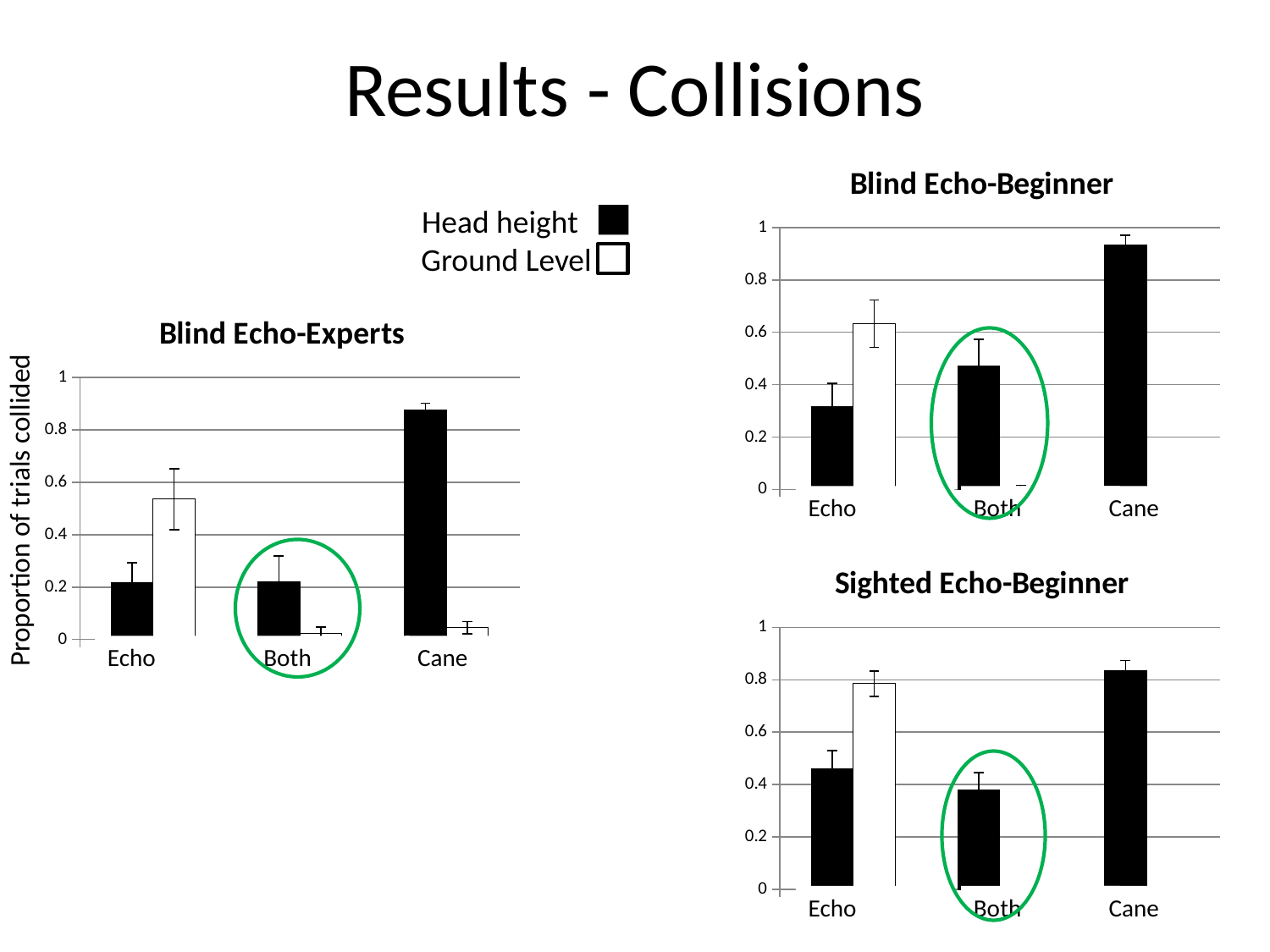
According to the legend, what colour represents Head height? black In the Sighted Echo-Beginner chart, which category has the lowest Head height bar? Both In the Blind Echo-Beginner chart, is the Head height value for Both greater or less than 0.6? less What kind of chart is the Blind Echo-Experts chart? bar chart How many categories are shown on the x axis of the Blind Echo-Beginner chart? 3 In the Blind Echo-Experts chart, is the Head height value for Cane greater or less than 0.8? greater In the Sighted Echo-Beginner chart, is the Head height value for Cane greater or less than 0.6? greater How many series does the legend list? 2 In the Sighted Echo-Beginner chart, for Echo, which is larger: the Head height bar or the Ground Level bar? Ground Level What is the y-axis label on the Blind Echo-Experts chart? Proportion of trials collided In the Blind Echo-Beginner chart, which category has the highest Head height bar? Cane